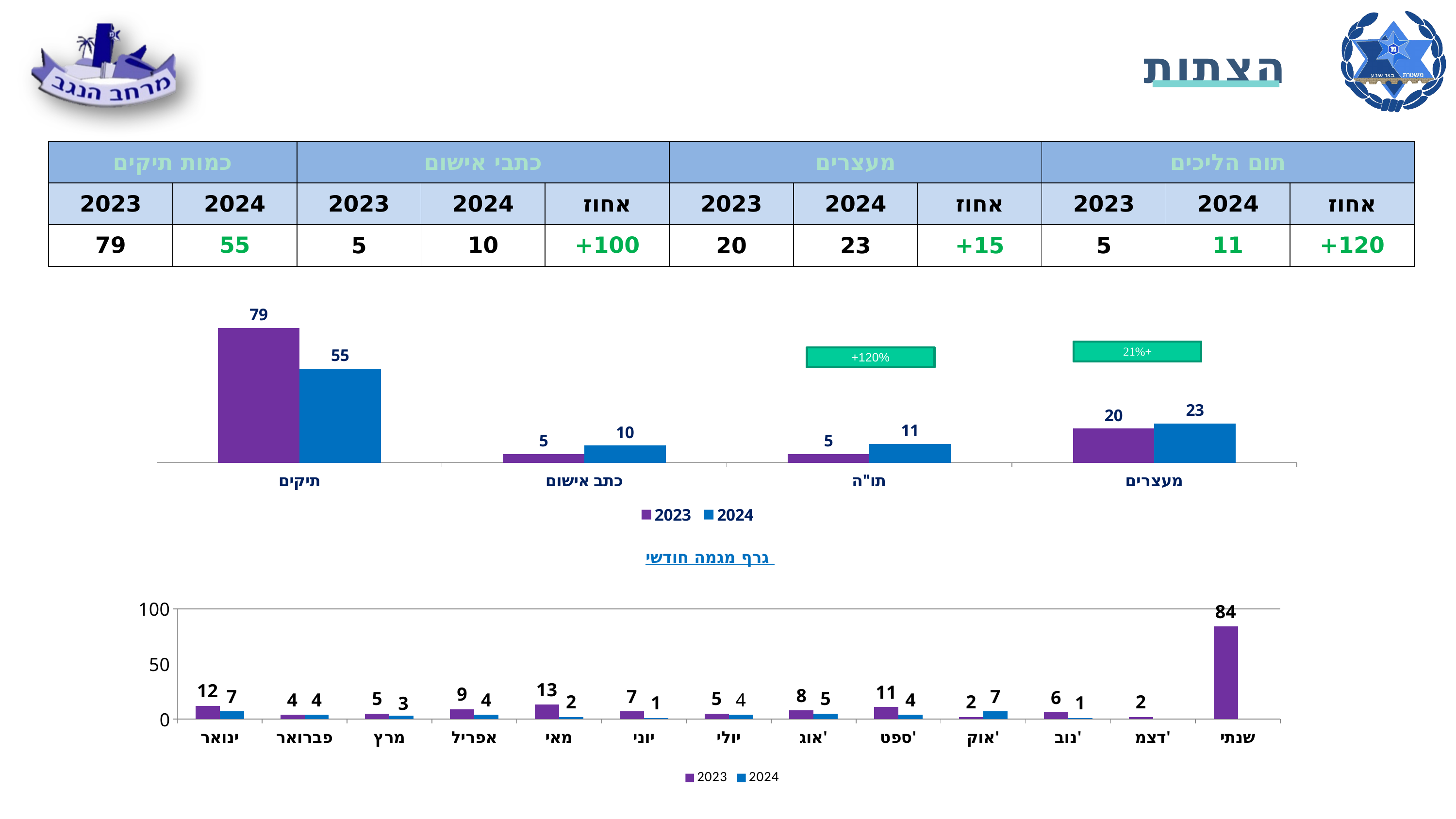
In the גרף מגמה חודשי chart, what is the 2023 value for מאי? 13 In the גרף מגמה חודשי chart, what is the difference between the 2023 and 2024 values for ספט'? 7 In the upper chart, what is the difference between the 2023 and 2024 values for תיקים? 24 In the upper chart, what is the 2024 value for מעצרים? 23 In the גרף מגמה חודשי chart, what is the 2024 value for אוק'? 7 In the upper chart, which category has the highest 2023 value? תיקים In the גרף מגמה חודשי chart, is the 2023 value for שנתי greater or less than 50? greater In the upper chart, which is larger for תו"ה: the 2023 value or the 2024 value? 2024 What kind of chart is the גרף מגמה חודשי chart? bar chart In the upper chart, what is the 2023 value for תיקים? 79 In the גרף מגמה חודשי chart, how many categories are shown on the x axis? 13 In the upper chart, how many series does the legend list? 2